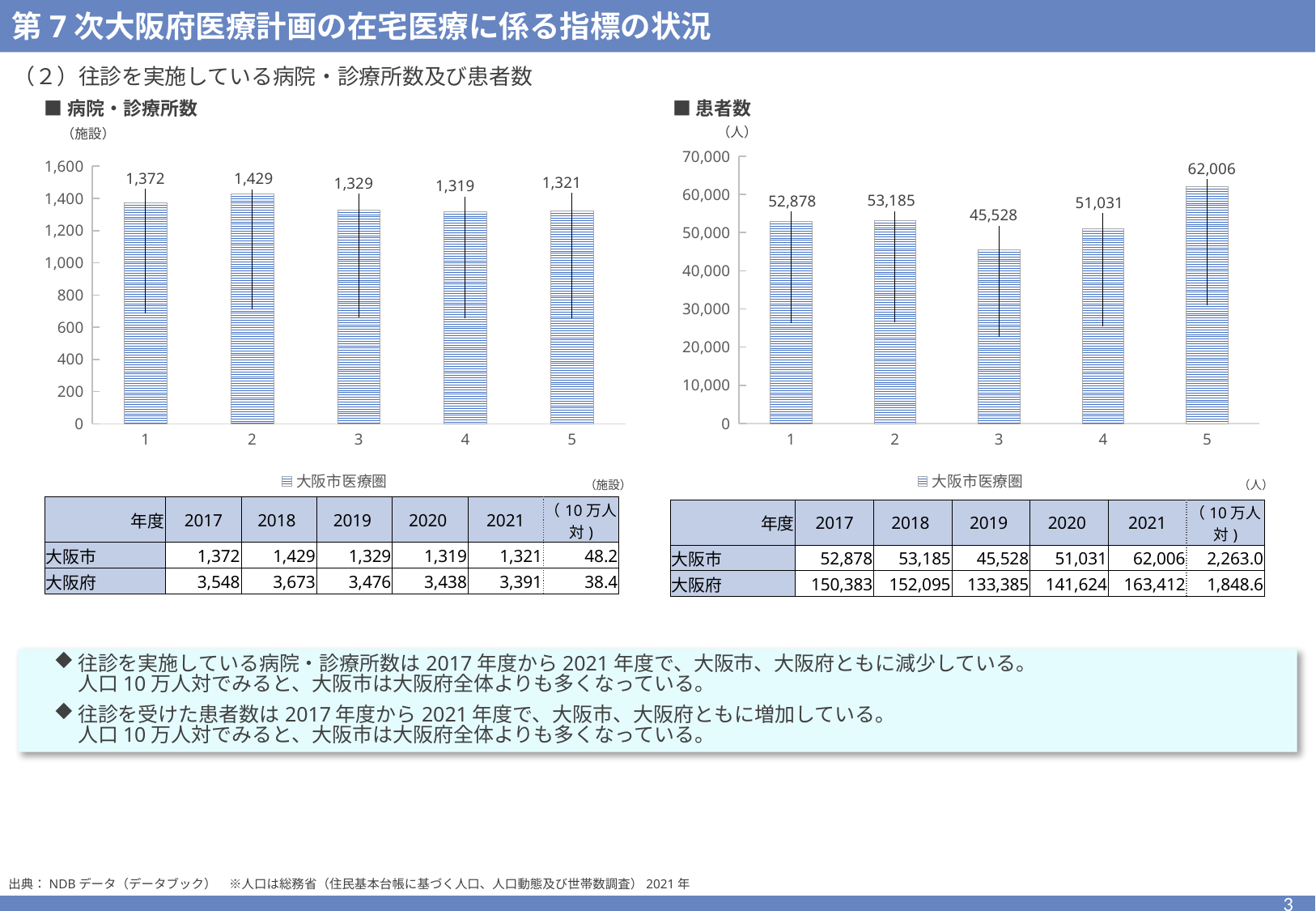
In the 患者数 chart, which is larger, the value for category 1 or category 2? category 2 In the 病院・診療所数 chart, how many bars are plotted? 5 In the 患者数 chart, which category has the highest value? 5 In the 病院・診療所数 chart, what series does the legend list? 大阪市医療圏 In the 患者数 chart, what is the value for category 3? 45,528 In the 病院・診療所数 chart, which category has the lowest value? 4 In the 患者数 chart, how many series does the legend list? 1 In the 病院・診療所数 chart, what is the value for category 2? 1,429 What kind of chart is the 患者数 chart? bar chart In the 患者数 chart, what is the difference between the values for category 5 and category 4? 10,975 In the 患者数 chart, is the value for category 5 greater or less than 60,000? greater In the 病院・診療所数 chart, what is the difference between the values for category 2 and category 1? 57